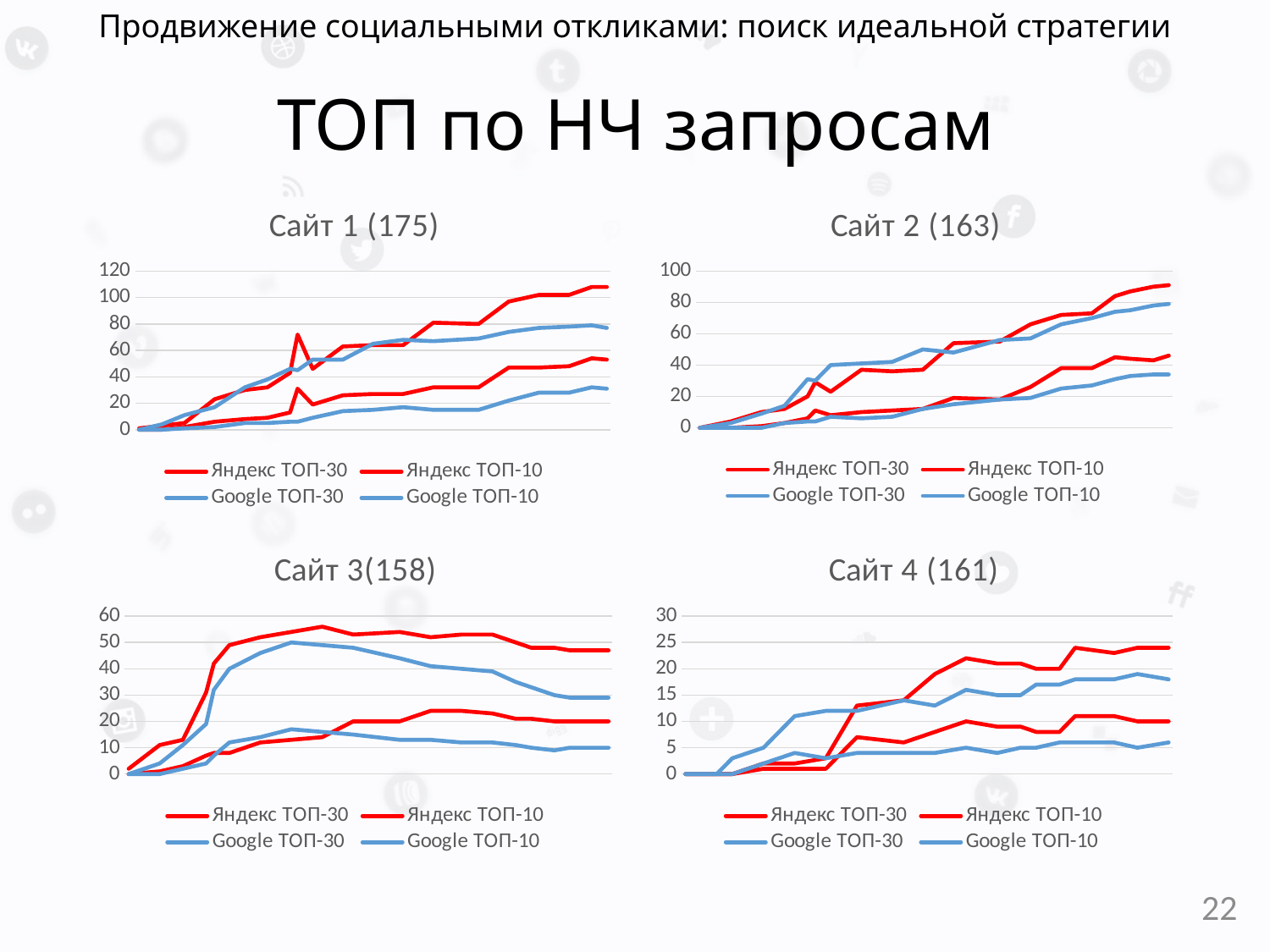
What kind of chart is the "Сайт 1 (175)" chart? line chart In the "Сайт 1 (175)" chart, which line ends higher at the right edge: Яндекс ТОП-30 or Google ТОП-30? Яндекс ТОП-30 How many series does the legend of the "Сайт 2 (163)" chart list? 4 In the "Сайт 3(158)" chart, is the peak value of the Яндекс ТОП-30 line greater or less than 50? greater In the "Сайт 2 (163)" chart, is the final value of the Яндекс ТОП-30 line greater or less than 80? greater In the "Сайт 1 (175)" chart, is the final value of the Яндекс ТОП-30 line greater or less than 100? greater In the "Сайт 4 (161)" chart, which series ends highest at the right edge? Яндекс ТОП-30 In the "Сайт 2 (163)" chart, does the Яндекс ТОП-30 line generally rise or fall along the x axis? rise What is the title of the top-left chart on the slide? Сайт 1 (175) In the "Сайт 3(158)" chart, does the Google ТОП-30 line rise or fall over the second half of the x axis? fall